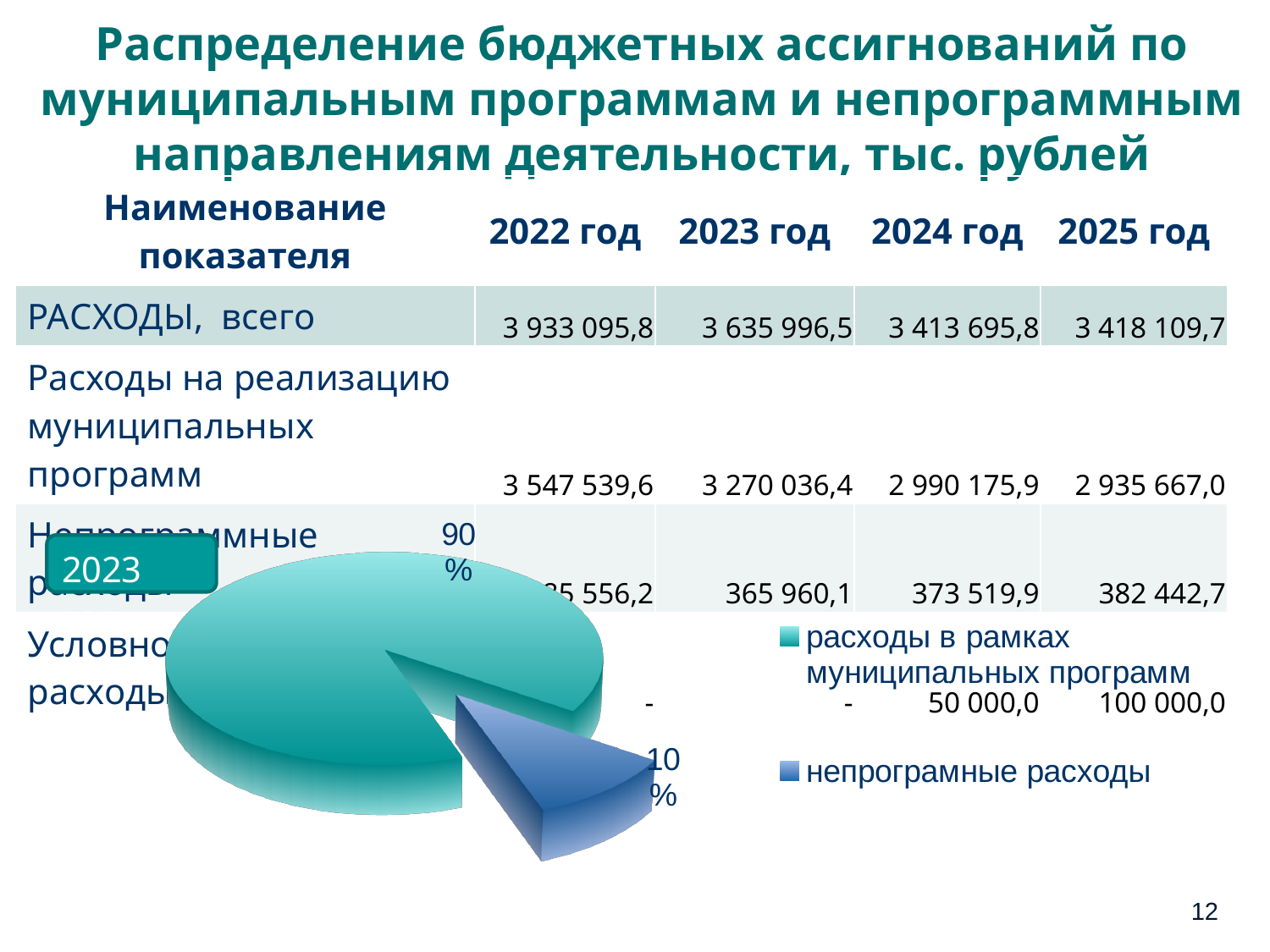
What colour is the 'непрограмные расходы' slice in the pie chart? blue What is the difference in percentage points between the two slices of the pie chart? 80 Which slice of the pie chart is the largest? расходы в рамках муниципальных программ How many entries does the pie chart's legend list? 2 In the pie chart, which is larger: 'расходы в рамках муниципальных программ' or 'непрограмные расходы'? расходы в рамках муниципальных программ Which slice of the pie chart is the smallest? непрограмные расходы How many slices does the pie chart have? 2 What share of the pie chart is labelled for 'непрограмные расходы'? 10% Which year is labelled on the pie chart? 2023 What share of the pie chart is labelled for 'расходы в рамках муниципальных программ'? 90% What kind of chart is shown on the slide? pie chart